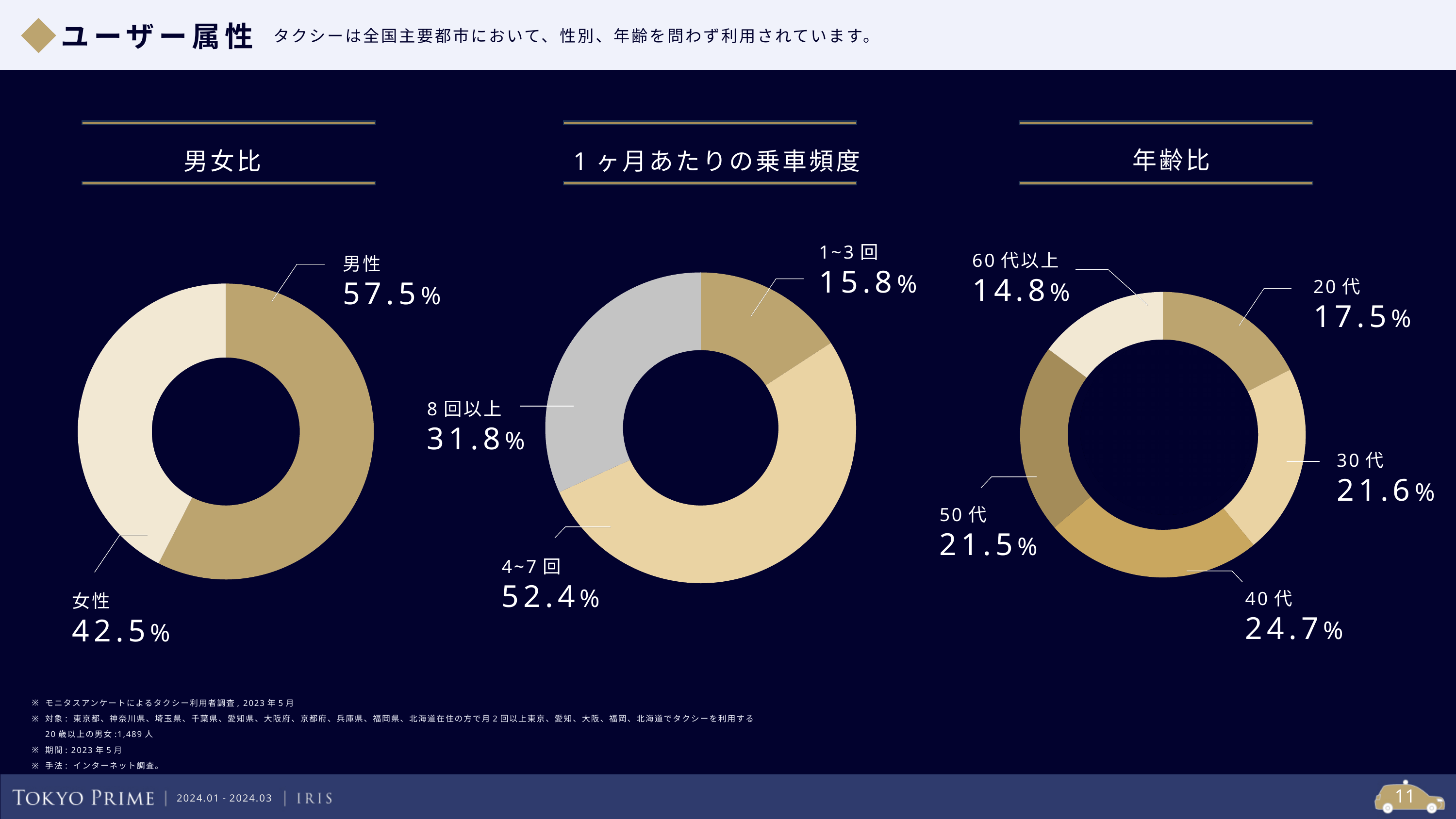
In the 年齢比 chart, what is the share for 40代? 24.7% In the 年齢比 chart, how many age groups are shown? 5 In the 1ヶ月あたりの乗車頻度 chart, what is the difference between the 8回以上 and 1~3回 shares? 16.0% What kind of chart is the 年齢比 chart? Doughnut chart In the 年齢比 chart, which age group has the smallest share? 60代以上 In the 男女比 chart, what is the difference between the 男性 and 女性 shares? 15.0% In the 年齢比 chart, which age group has the largest share? 40代 In the 男女比 chart, what is the share for 男性? 57.5% In the 1ヶ月あたりの乗車頻度 chart, which category has the smallest share? 1~3回 In the 1ヶ月あたりの乗車頻度 chart, how many categories are shown? 3 In the 1ヶ月あたりの乗車頻度 chart, what is the share for 4~7回? 52.4% In the 男女比 chart, what is the share for 女性? 42.5%